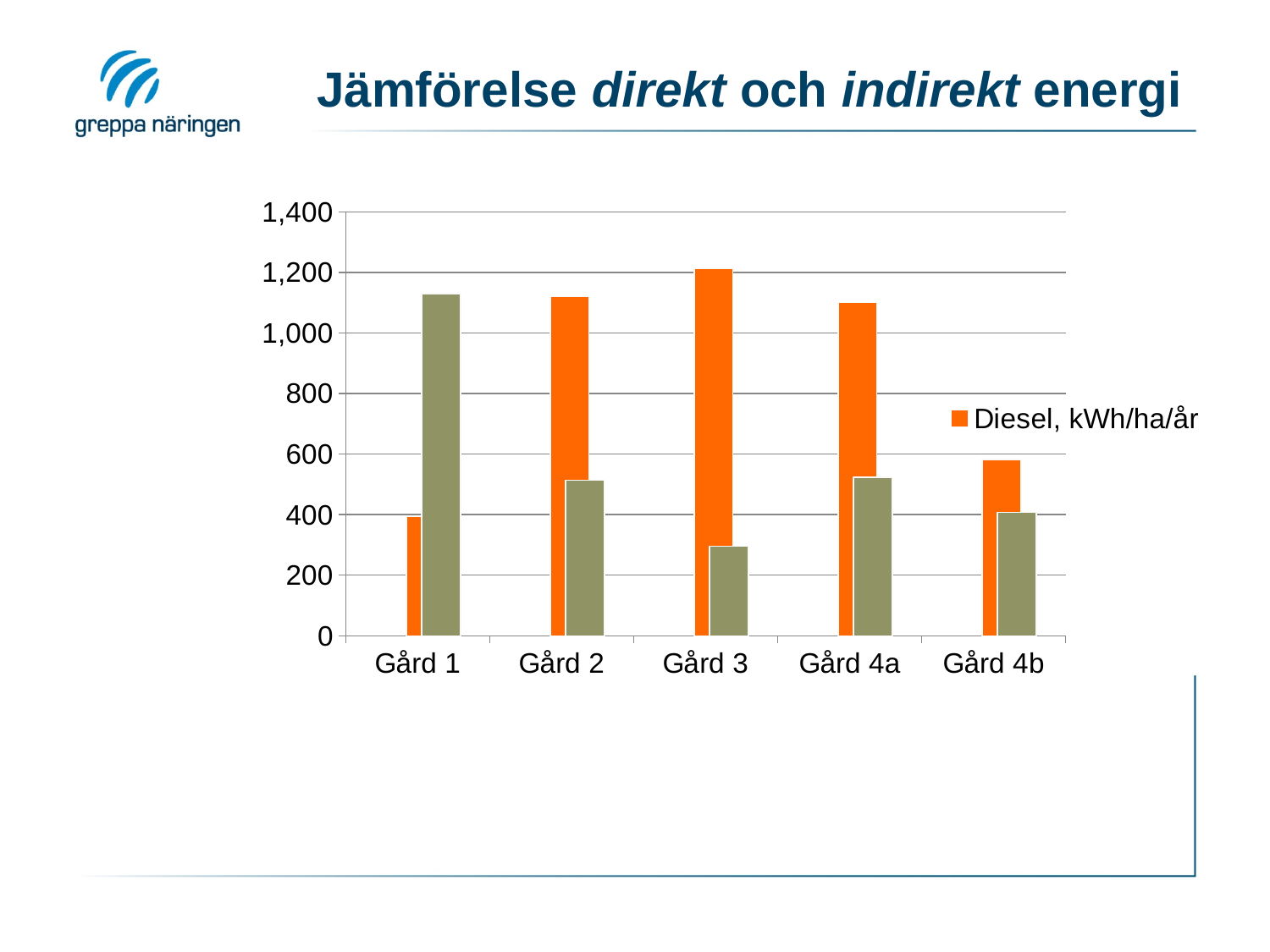
How many series does the legend list? 1 How many farms (categories) are shown on the x axis? 5 Is the grey bar for Gård 3 greater or less than 400? less Which farm has the lowest value for the grey (second) series? Gård 3 Which farm has the highest value for the grey (second) series? Gård 1 Which farm has the lowest Diesel, kWh/ha/år value? Gård 1 For Gård 1, which is larger: the Diesel bar or the grey bar? the grey bar Which farm has the highest Diesel, kWh/ha/år value? Gård 3 What kind of chart is shown on the slide? bar chart Is the Diesel, kWh/ha/år value for Gård 2 greater or less than 1,000? greater What is the legend entry shown on the chart? Diesel, kWh/ha/år Is the Diesel, kWh/ha/år value for Gård 4b greater or less than 400? greater